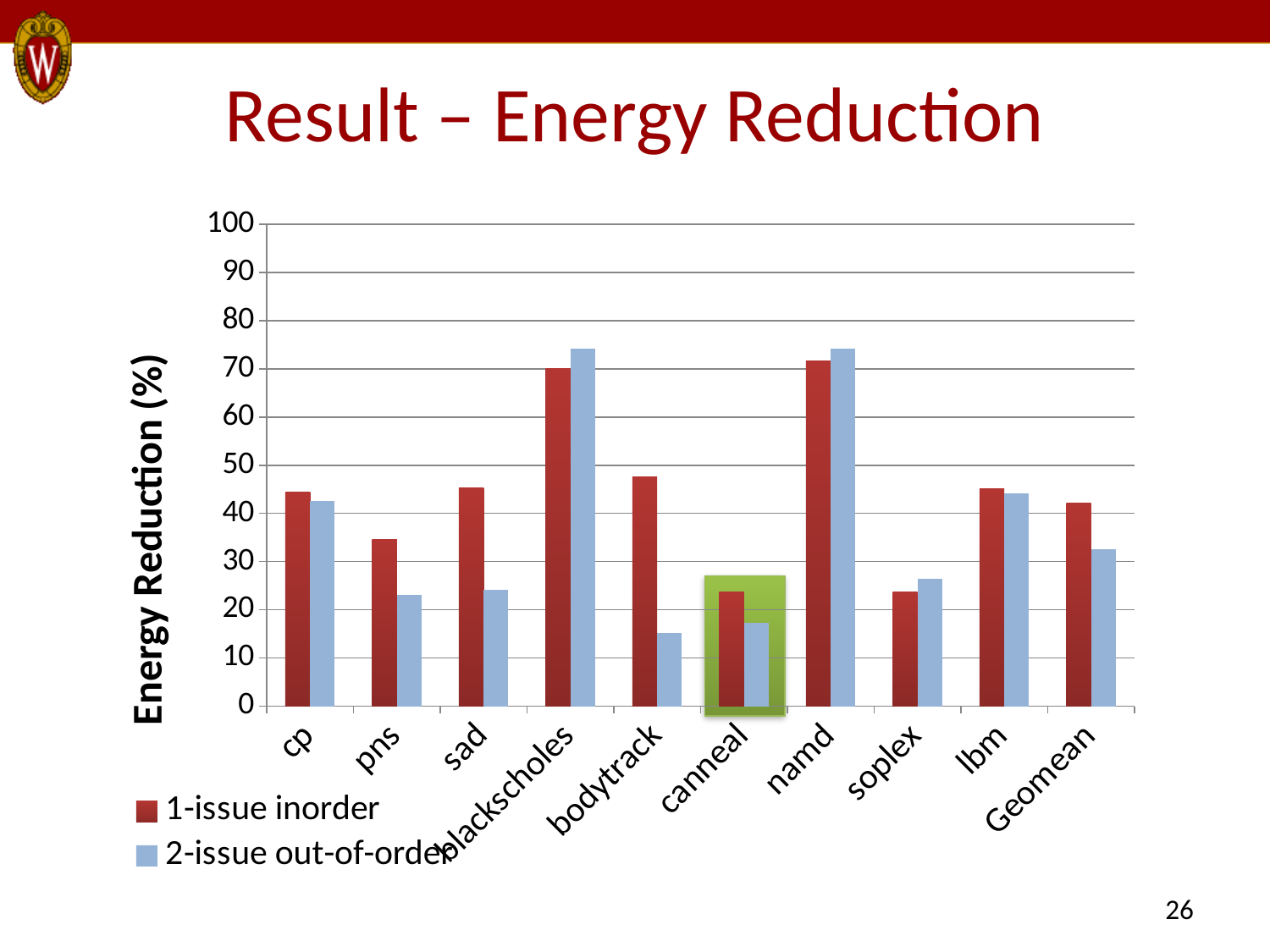
Is the 1-issue inorder value for canneal greater or less than 30? less What kind of chart is shown on the slide? bar chart How many benchmark categories are shown on the x axis of the chart? 10 For bodytrack, which series has the larger energy reduction, 1-issue inorder or 2-issue out-of-order? 1-issue inorder How many series does the chart's legend list? 2 For soplex, which series has the larger energy reduction, 1-issue inorder or 2-issue out-of-order? 2-issue out-of-order Is the 2-issue out-of-order value for Geomean greater or less than 30? greater Is the 2-issue out-of-order value for pns greater or less than 30? less Which benchmark category is highlighted with a green box on the chart? canneal What is the label of the y axis of the chart? Energy Reduction (%)